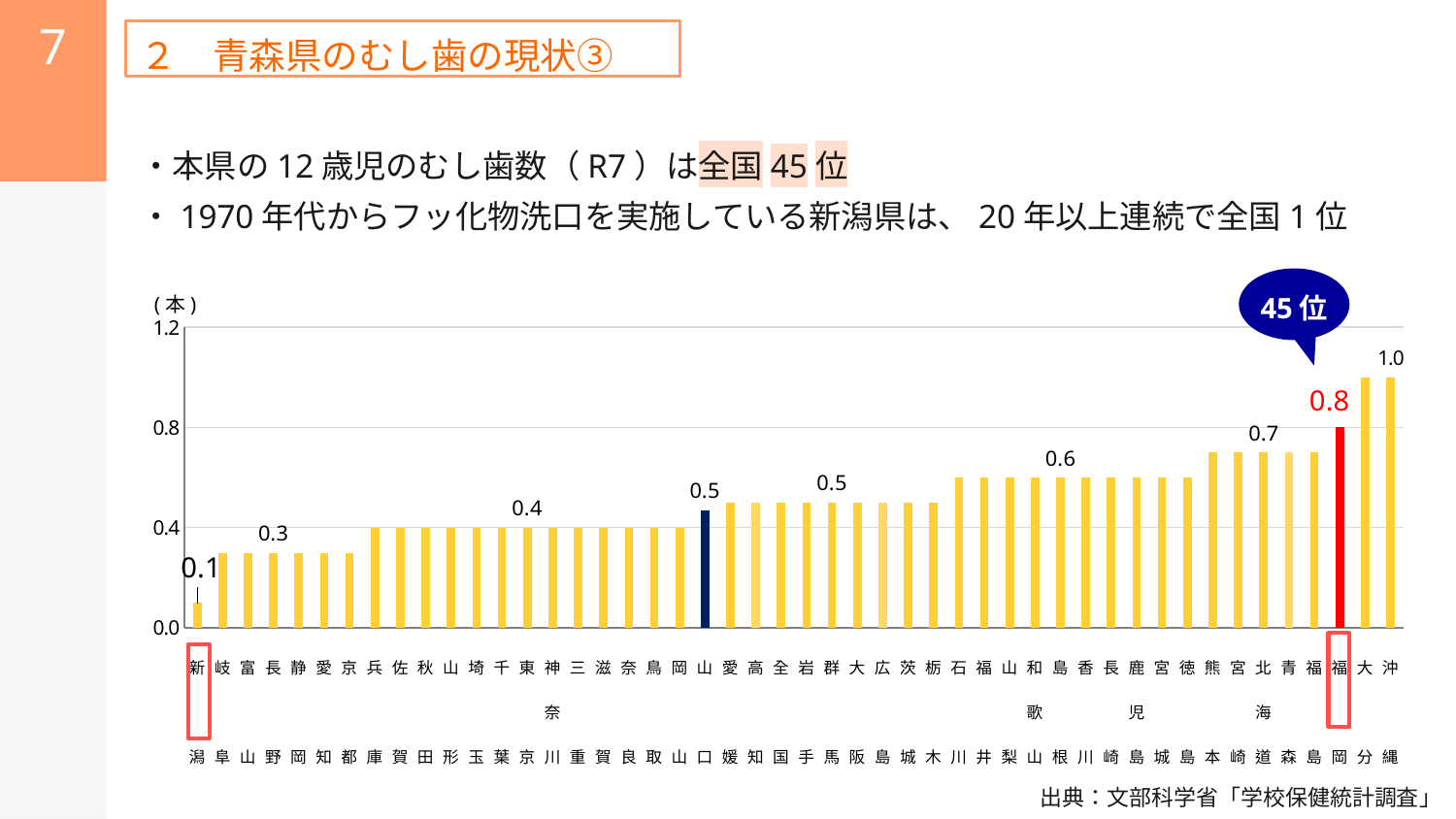
What is the value for 山口 (the dark blue bar) in the bar chart? 0.5 Which prefecture has the lowest value in the bar chart? 新潟 What is the difference between the values for 福岡 and 新潟? 0.7 What kind of chart is shown on the slide? bar chart Do the values generally rise or fall from left to right along the x axis? rise Is the value for 石川 greater or less than 0.4? greater Is the value for 青森 greater or less than 0.8? less What is the value for 福岡 (the red bar) in the bar chart? 0.8 What rank is shown in the callout above the red bar for 福岡? 45位 What is the value for 新潟 in the bar chart? 0.1 Which has the larger value, 福岡 or 山口? 福岡 What is the value for 沖縄 in the bar chart? 1.0